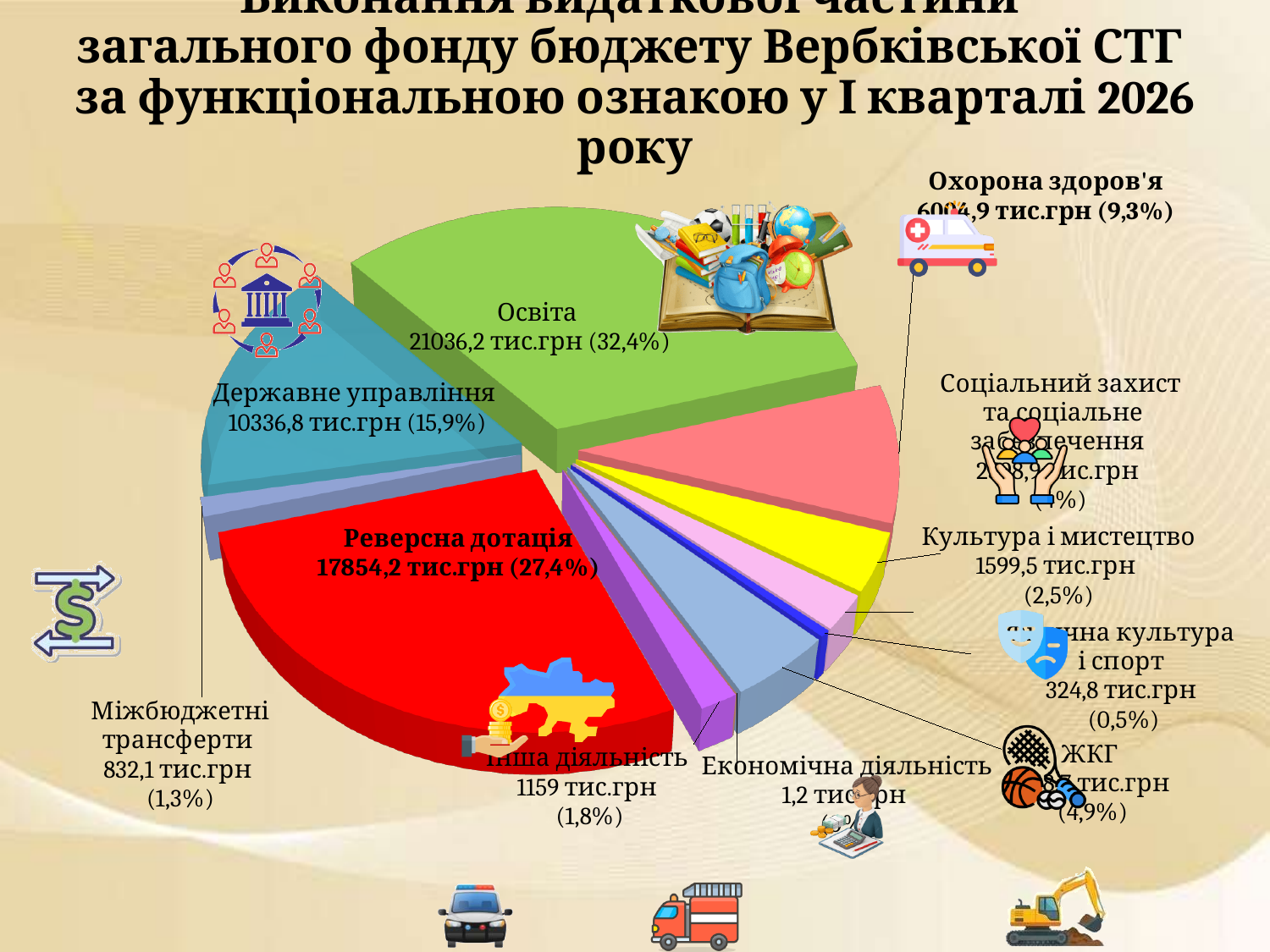
What is the value for Реверсна дотація? 17854,2 тис.грн What is the value for Культура і мистецтво? 1599,5 тис.грн What kind of chart is shown on the slide? pie chart Which is larger, Реверсна дотація or Державне управління? Реверсна дотація What is the value for Освіта? 21036,2 тис.грн What share of the pie does Охорона здоров'я represent? 9,3% Which category has the largest share of the pie? Освіта Which category has the smallest value shown on the chart? Економічна діяльність What share of the pie does Освіта represent? 32,4% What share of the pie does Державне управління represent? 15,9% What is the value for Міжбюджетні трансферти? 832,1 тис.грн What is the difference in value between Освіта and Реверсна дотація? 3182 тис.грн